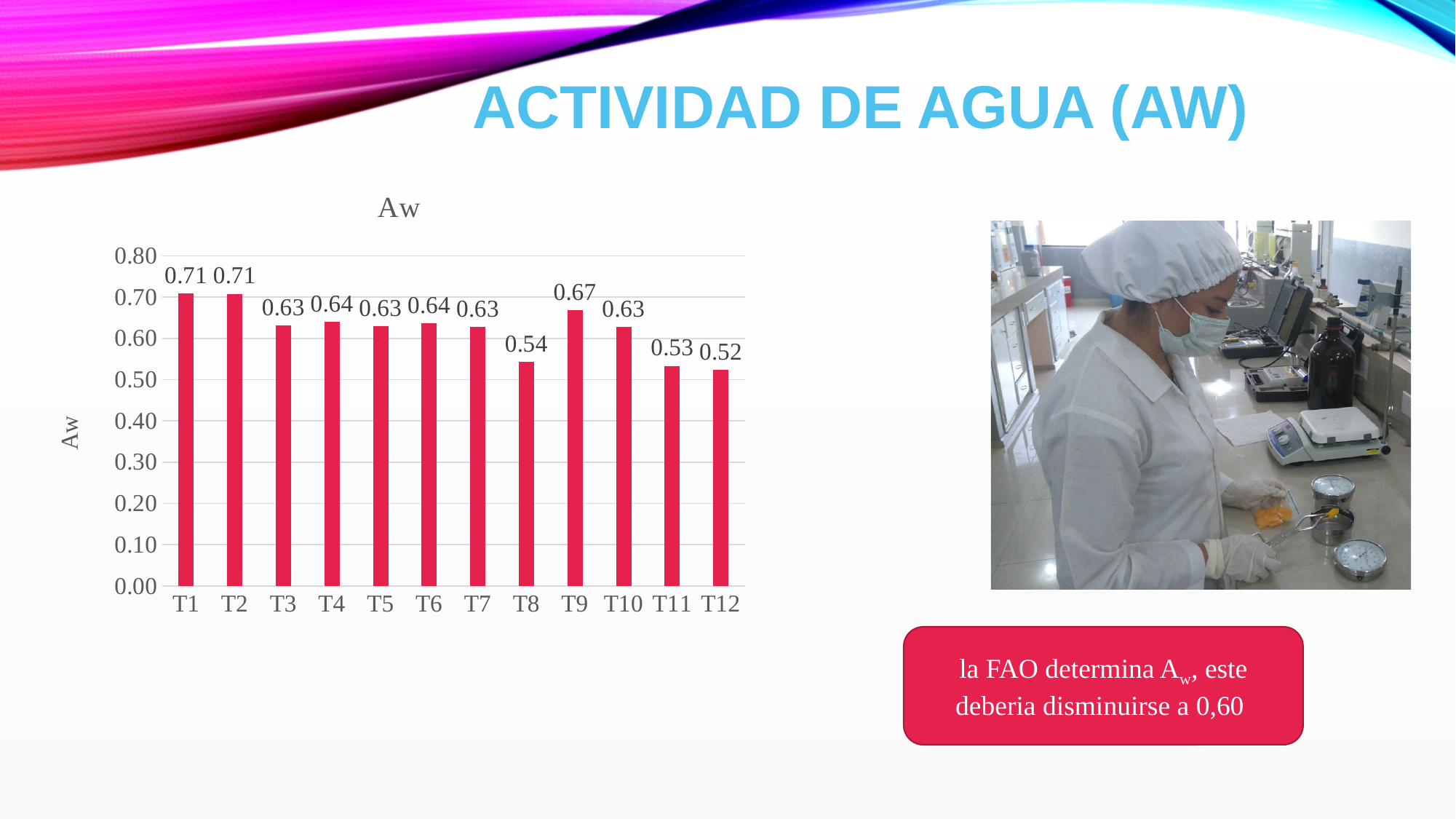
What is the Aw value for T1? 0.71 What is the difference between the Aw values of T1 and T12? 0.19 What is the title of the chart? Aw What is the Aw value for T9? 0.67 Which has a higher Aw value, T9 or T10? T9 Is the Aw value for T11 greater or less than 0.60? less Which treatment has the lowest Aw value? T12 What is the Aw value for T8? 0.54 What is the Aw value for T12? 0.52 What is the difference between the Aw values of T9 and T8? 0.13 How many treatments are shown on the x axis of the chart? 12 What type of chart is used to show the Aw values? bar chart